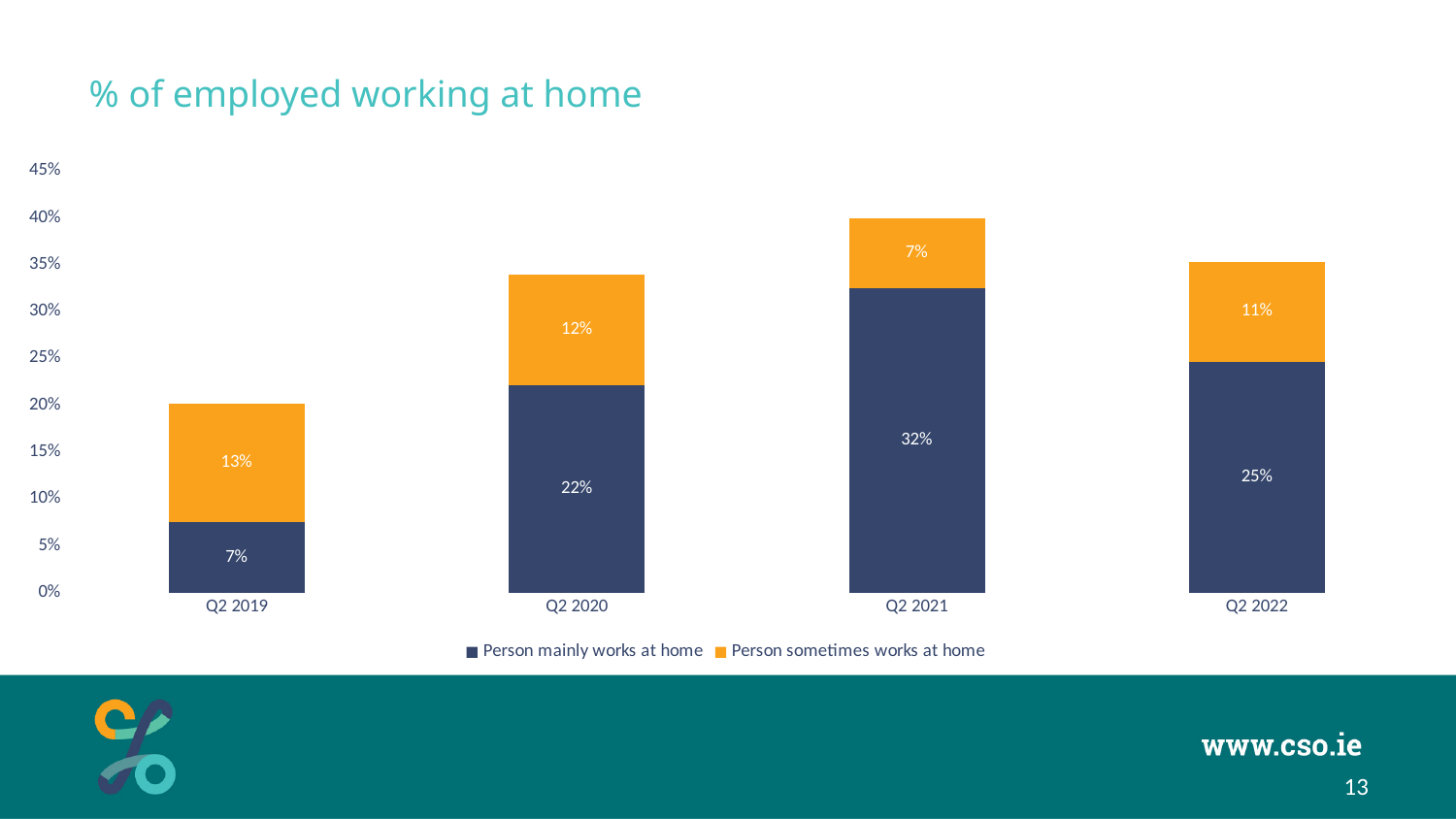
Which is larger: 'Person sometimes works at home' in Q2 2020 or in Q2 2022? Q2 2020 In which quarter is the 'Person mainly works at home' value highest? Q2 2021 What is the value for 'Person mainly works at home' in Q2 2022? 25% What is the difference between the 'Person mainly works at home' values for Q2 2020 and Q2 2019? 15% What is the total of the stacked bar for Q2 2019? 20% What percentage of employed persons mainly worked at home in Q2 2021? 32% What is the value for 'Person sometimes works at home' in Q2 2019? 13% In which quarter is the 'Person sometimes works at home' value lowest? Q2 2021 How many series does the legend list? 2 What kind of chart is shown on the slide? Stacked bar chart How many quarters are shown on the x axis? 4 What is the total of the stacked bar for Q2 2021? 39%